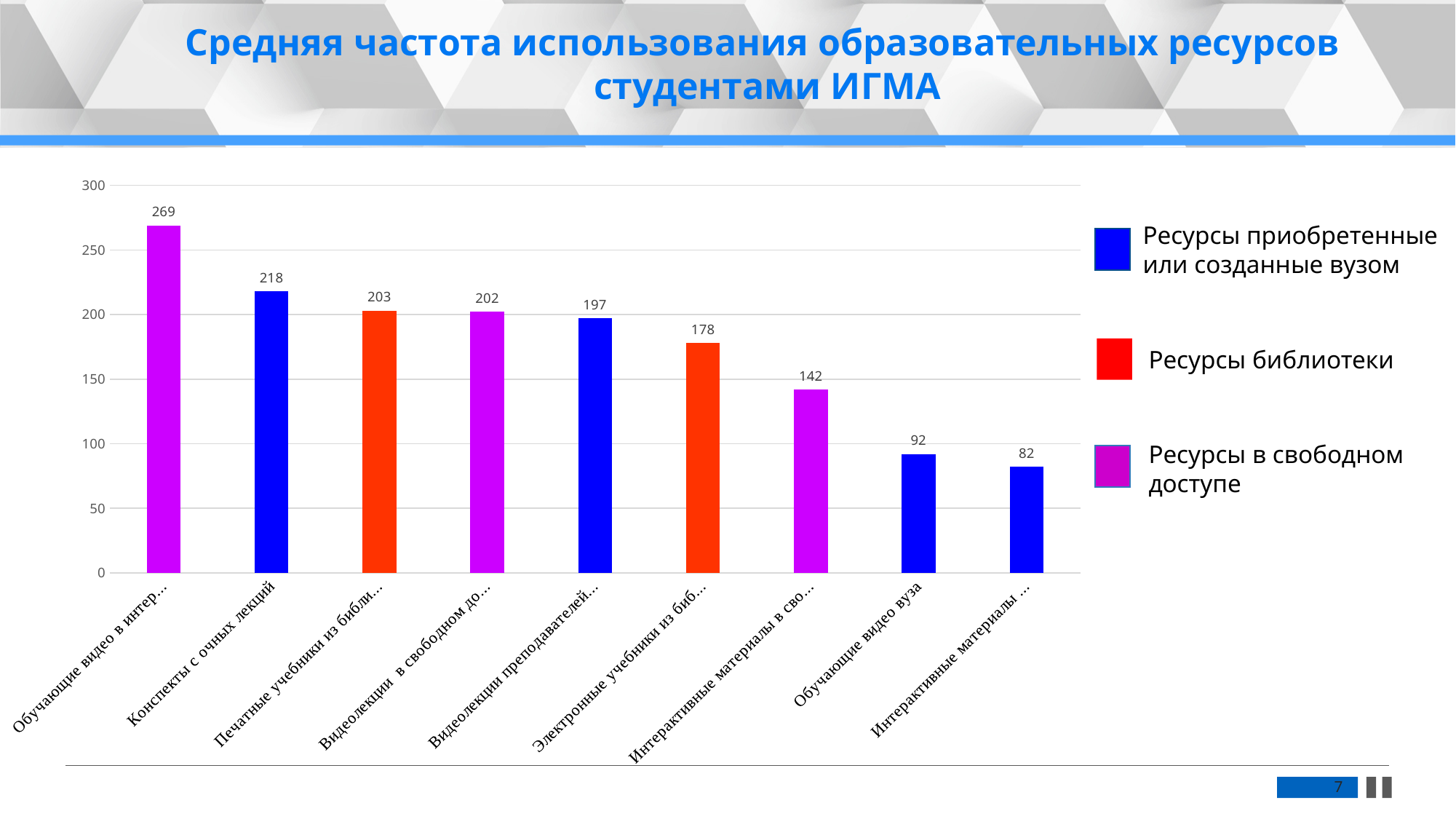
Is the value for 'Обучающие видео вуза' greater or less than 100? less Which has a larger value: 'Конспекты с очных лекций' or 'Обучающие видео вуза'? Конспекты с очных лекций How many bars (categories) are plotted in the chart? 9 What is the value for 'Конспекты с очных лекций'? 218 What type of chart is shown on the slide? Bar chart Do the bar values rise or fall from left to right along the x axis? Fall Which legend entry is shown in red? Ресурсы библиотеки What is the highest value shown in the chart? 269 How many series does the legend list? 3 What is the value for 'Обучающие видео вуза'? 92 What is the difference between the values for 'Конспекты с очных лекций' and 'Обучающие видео вуза'? 126 What is the lowest value shown in the chart? 82